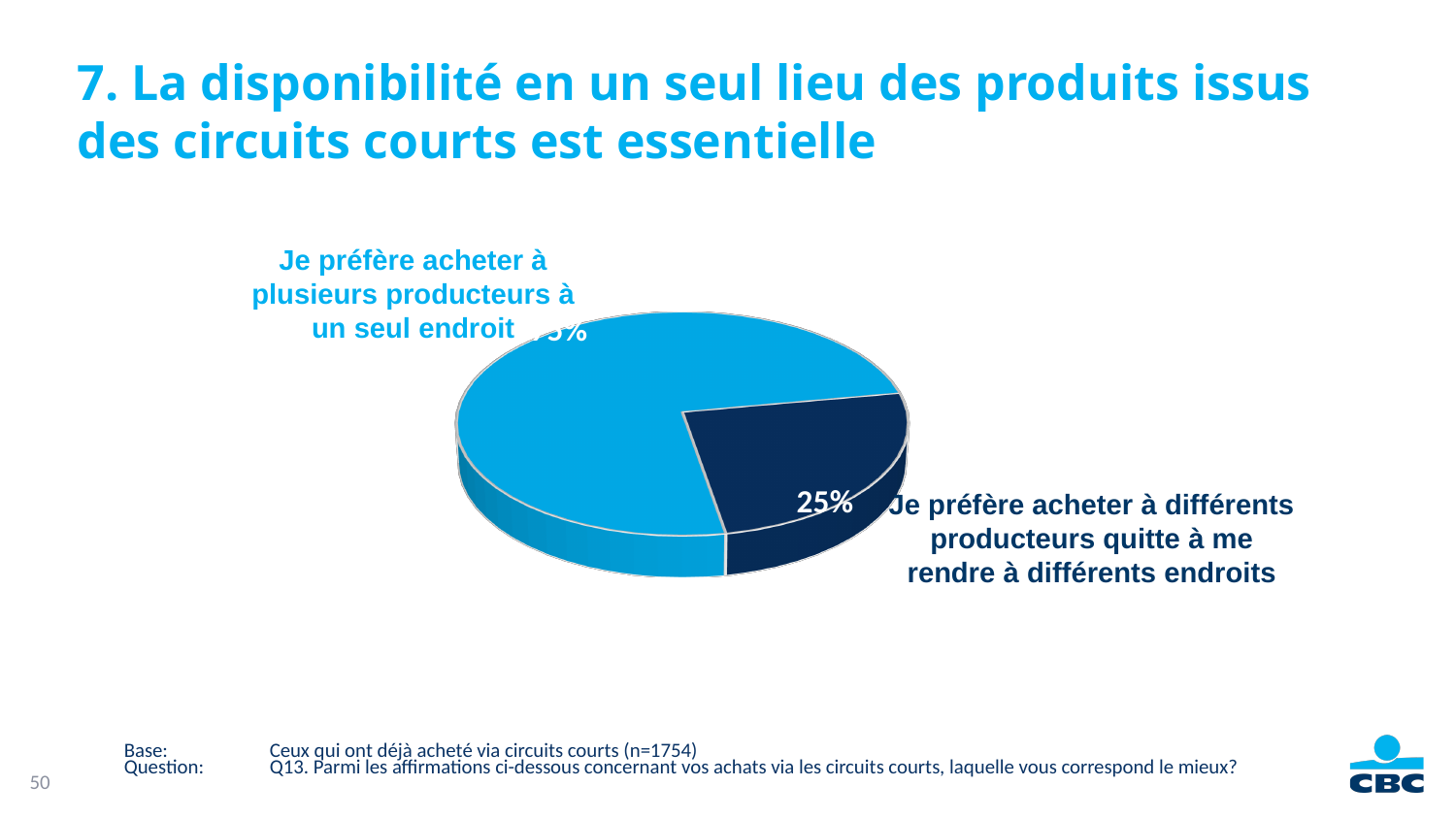
What colour is the slice representing "Je préfère acheter à différents producteurs quitte à me rendre à différents endroits"? dark blue How many slices does the pie chart have? 2 What is the sample size (n) given in the base note below the chart? n=1754 Which slice of the pie chart is the smallest? Je préfère acheter à différents producteurs quitte à me rendre à différents endroits What percentage of respondents prefer to buy from different producers even if it means going to different places ("Je préfère acheter à différents producteurs quitte à me rendre à différents endroits")? 25% Is the share for "Je préfère acheter à plusieurs producteurs à un seul endroit" greater or less than 50%? greater Which is larger: the share for "Je préfère acheter à plusieurs producteurs à un seul endroit" or the share for "Je préfère acheter à différents producteurs quitte à me rendre à différents endroits"? Je préfère acheter à plusieurs producteurs à un seul endroit Is the share for "Je préfère acheter à différents producteurs quitte à me rendre à différents endroits" greater or less than 50%? less What kind of chart is shown on the slide? pie chart Which slice of the pie chart is the largest? Je préfère acheter à plusieurs producteurs à un seul endroit